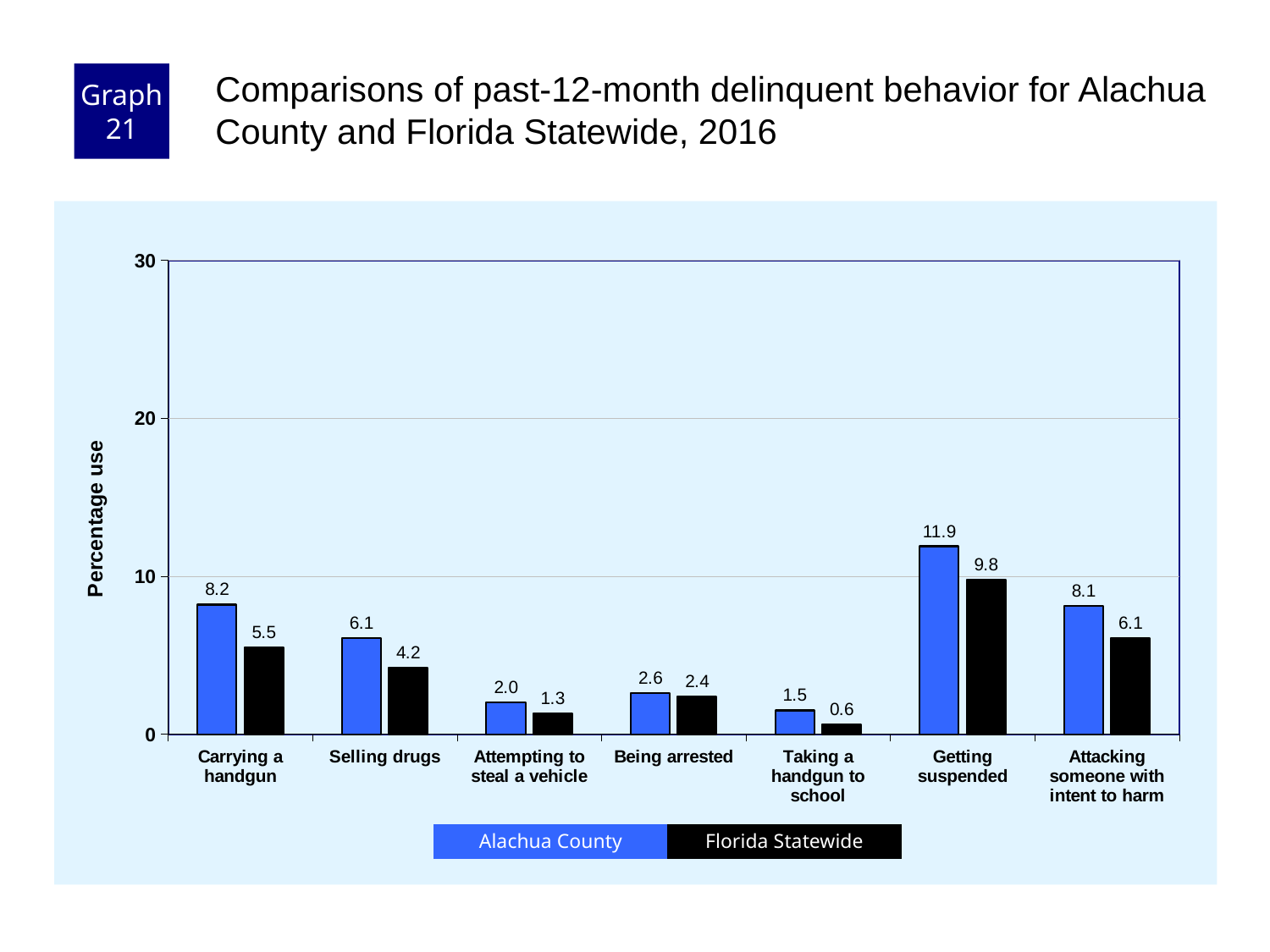
Is the Alachua County value for Getting suspended greater or less than 10? greater Which category has the lowest Florida Statewide value? Taking a handgun to school What is the Florida Statewide value for Getting suspended? 9.8 What is the Alachua County value for Carrying a handgun? 8.2 How many series does the legend list? 2 What is the difference between the Alachua County and Florida Statewide values for Selling drugs? 1.9 Which is larger for Carrying a handgun: the Alachua County value or the Florida Statewide value? Alachua County How many categories are shown on the x axis? 7 Which category has the highest Alachua County value? Getting suspended What is the difference between the Alachua County and Florida Statewide values for Attacking someone with intent to harm? 2.0 What is the Florida Statewide value for Taking a handgun to school? 0.6 What kind of chart is shown on the slide? Bar chart